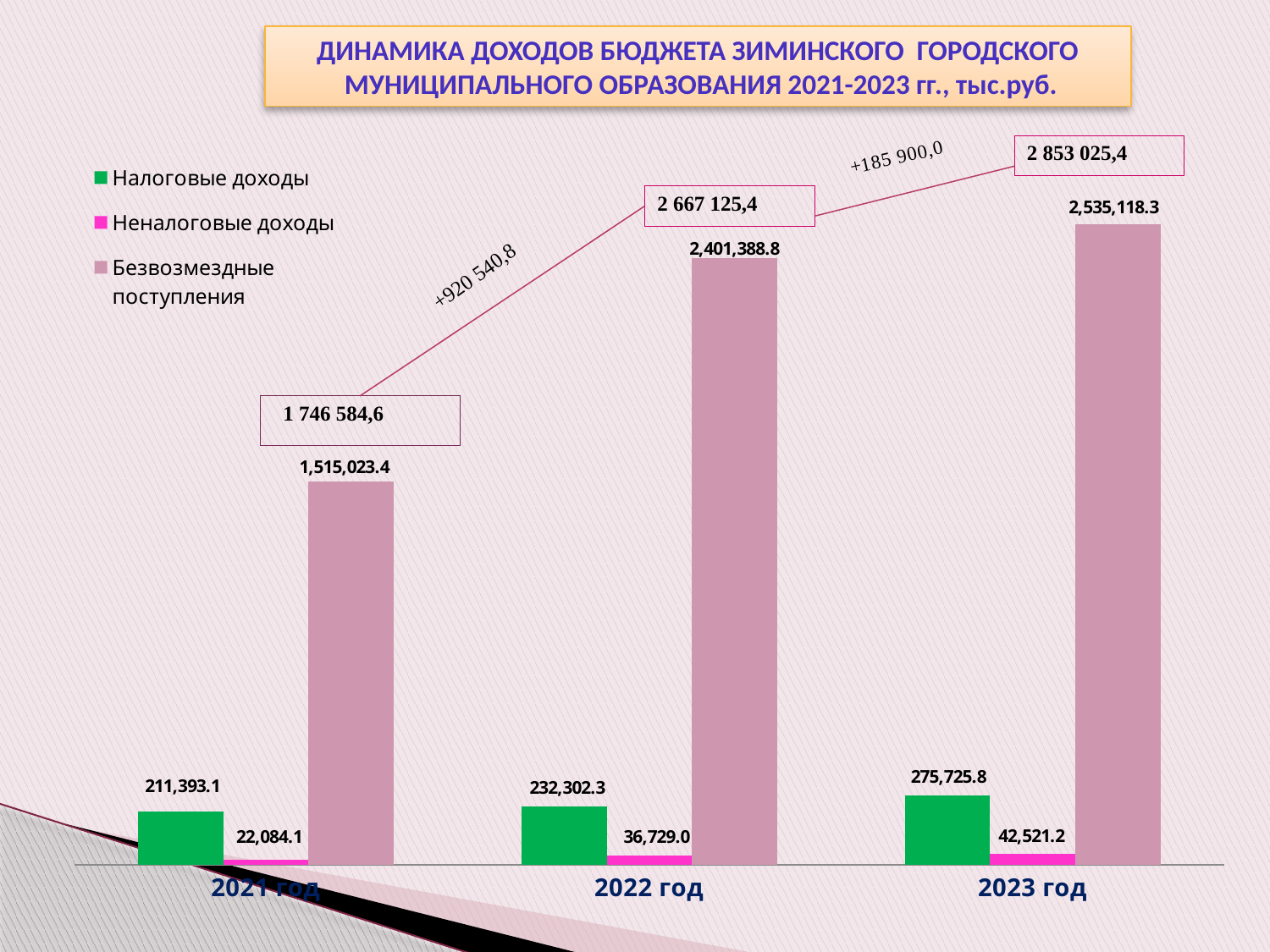
In which year is Неналоговые доходы the lowest? 2021 год What is the value of Неналоговые доходы for 2023 год? 42,521.2 What kind of chart is shown on the slide? Bar chart Do the values of Безвозмездные поступления rise or fall from 2021 год to 2023 год? Rise What is the value of Безвозмездные поступления for 2022 год? 2,401,388.8 What is the value of Налоговые доходы for 2023 год? 275,725.8 How many series does the legend list? 3 How many years are shown on the x axis? 3 What is the difference between Налоговые доходы in 2022 год and 2021 год? 20,909.2 Which is larger: Неналоговые доходы in 2022 год or Налоговые доходы in 2021 год? Налоговые доходы in 2021 год In which year is Безвозмездные поступления the highest? 2023 год What is the value of Налоговые доходы for 2021 год? 211,393.1